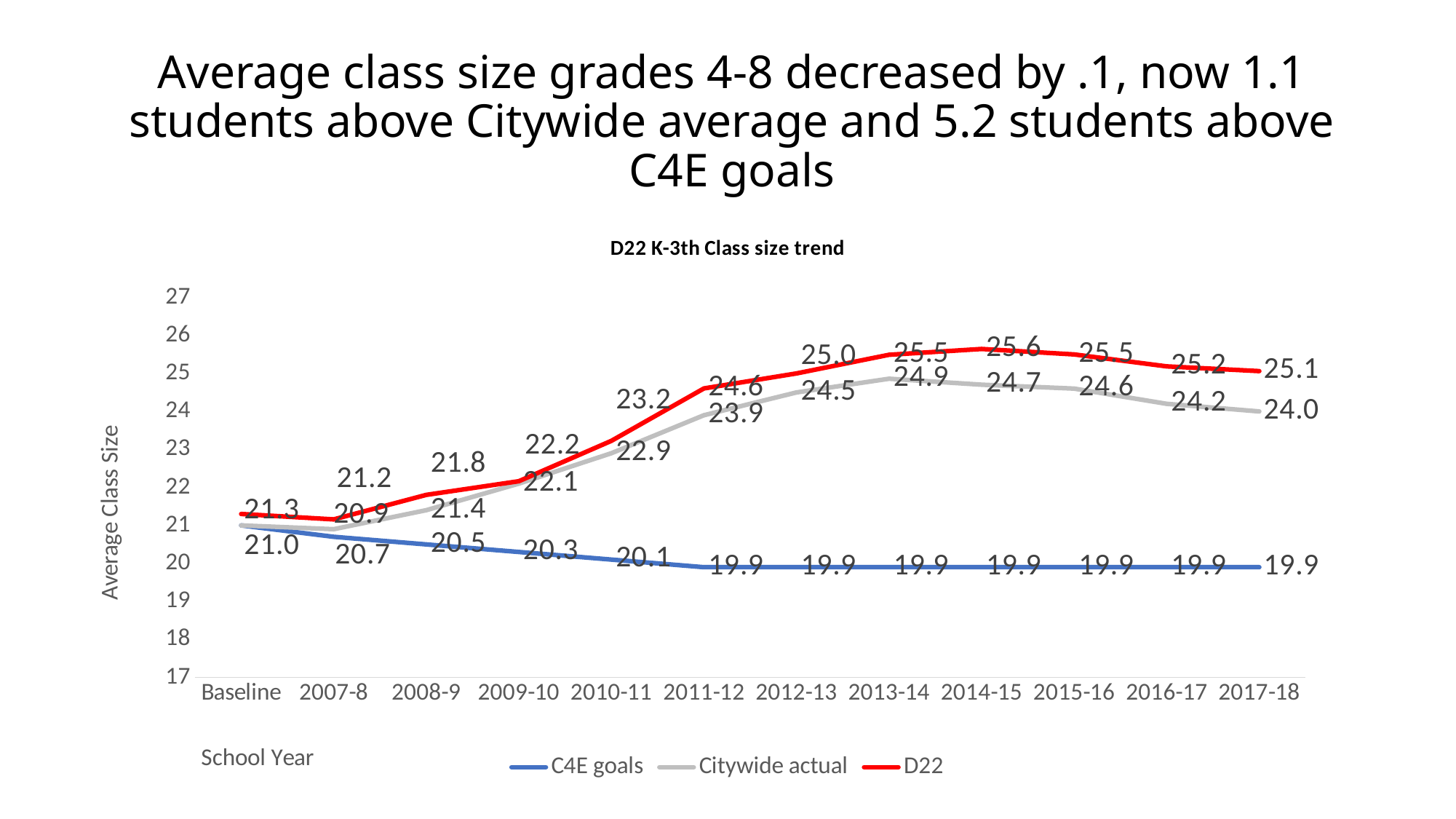
In which school year does the D22 series reach its highest value? 2014-15 What type of chart is shown on the slide? Line chart What is the title of the chart? D22 K-3th Class size trend What is the difference between the D22 value and the Citywide actual value in 2017-18? 1.1 How many school years (points) are plotted along the x axis? 12 Which is larger in 2011-12, the D22 value or the Citywide actual value? D22 What is the D22 value for 2017-18? 25.1 What is the C4E goals value for 2009-10? 20.3 How many series does the legend list? 3 What is the Citywide actual value for 2013-14? 24.9 What is the lowest value shown for the C4E goals series? 19.9 Does the C4E goals series rise or fall from Baseline to 2011-12? Fall